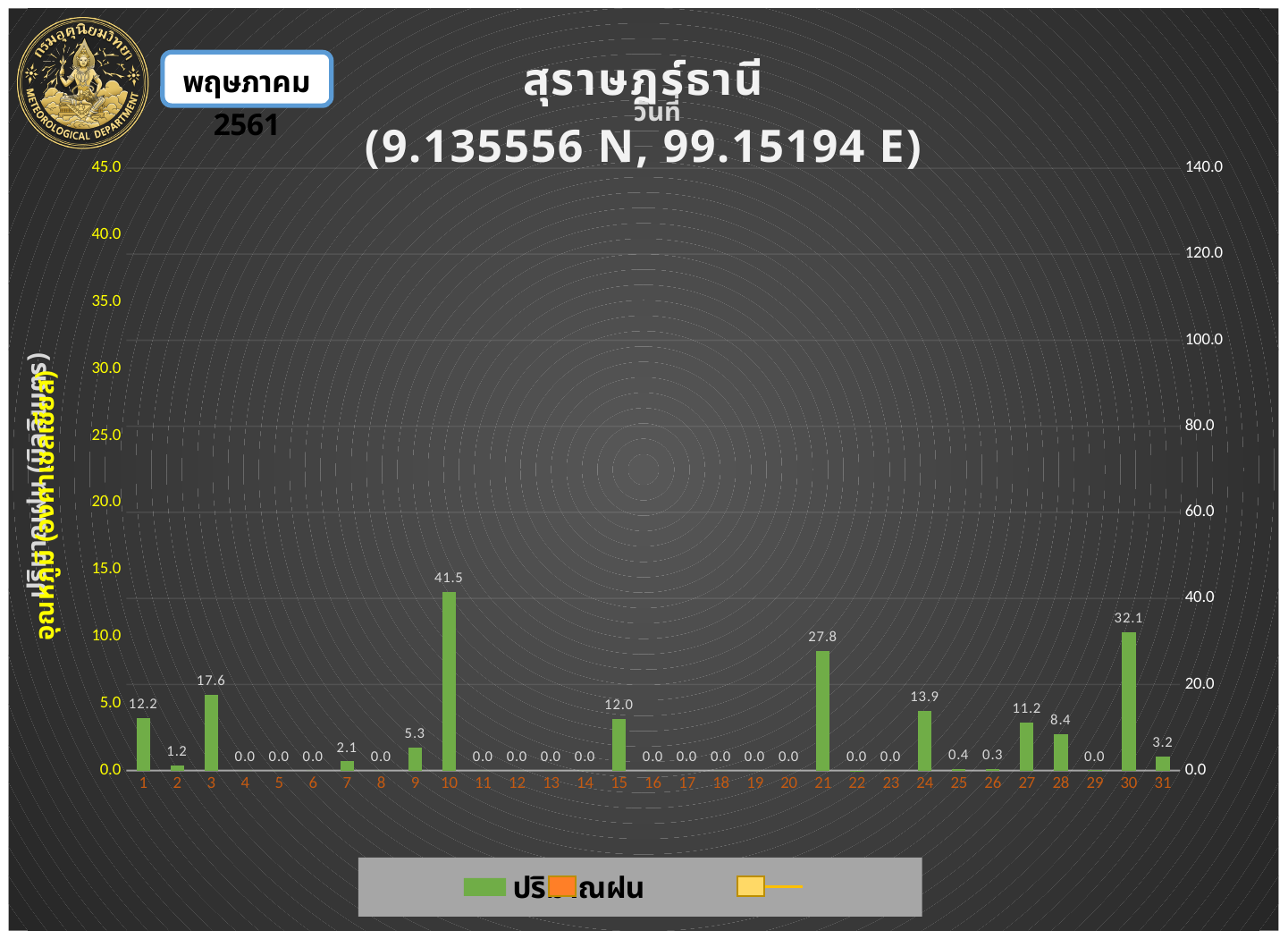
What kind of chart is used to show the rainfall values? bar chart How many days have a rainfall value of 0.0? 16 What is the rainfall value shown for day 1? 12.2 What coordinates are given in the chart title? 9.135556 N, 99.15194 E How many days are shown on the x axis? 31 Which has the larger rainfall value, day 3 or day 24? day 3 Which day has the highest rainfall bar? 10 What is the difference between the rainfall values for day 10 and day 30? 9.4 What is the rainfall value shown for day 10? 41.5 What is the difference between the rainfall values for day 30 and day 21? 4.3 What is the rainfall value shown for day 21? 27.8 What is the rainfall value shown for day 28? 8.4